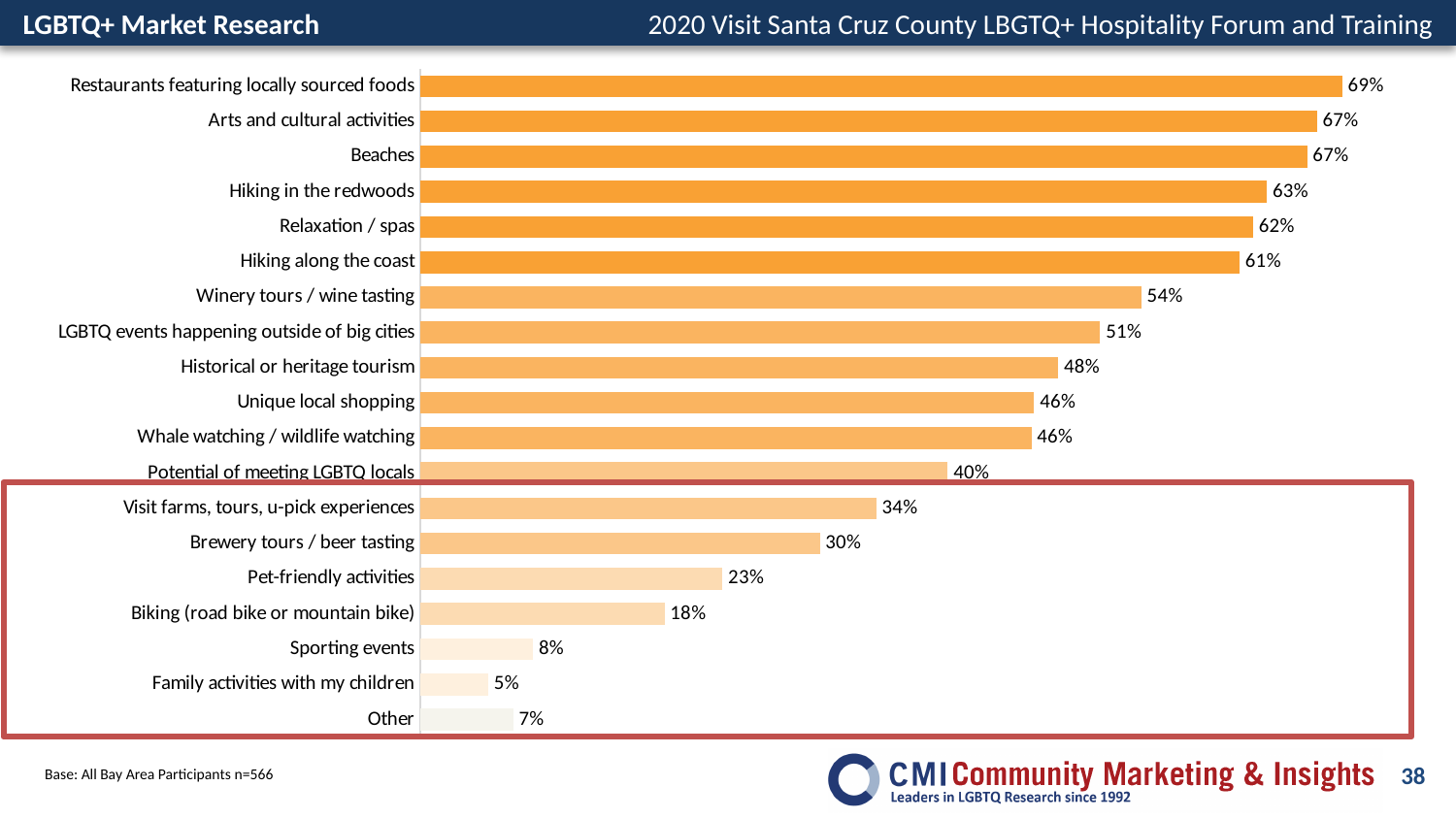
What is the difference between the values for Pet-friendly activities and Sporting events? 15% What is the value for Brewery tours / beer tasting? 30% Which is larger, the value for Potential of meeting LGBTQ locals or the value for Visit farms, tours, u-pick experiences? Potential of meeting LGBTQ locals What is the value for Family activities with my children? 5% What is the base sample size noted at the bottom of the slide? n=566 What kind of chart is shown on the slide? Bar chart Which category has the lowest value? Family activities with my children What is the value for Restaurants featuring locally sourced foods? 69% Which category has the highest value? Restaurants featuring locally sourced foods What is the value for Winery tours / wine tasting? 54% How many categories are shown in the chart? 19 What is the difference between the values for Hiking in the redwoods and Hiking along the coast? 2%